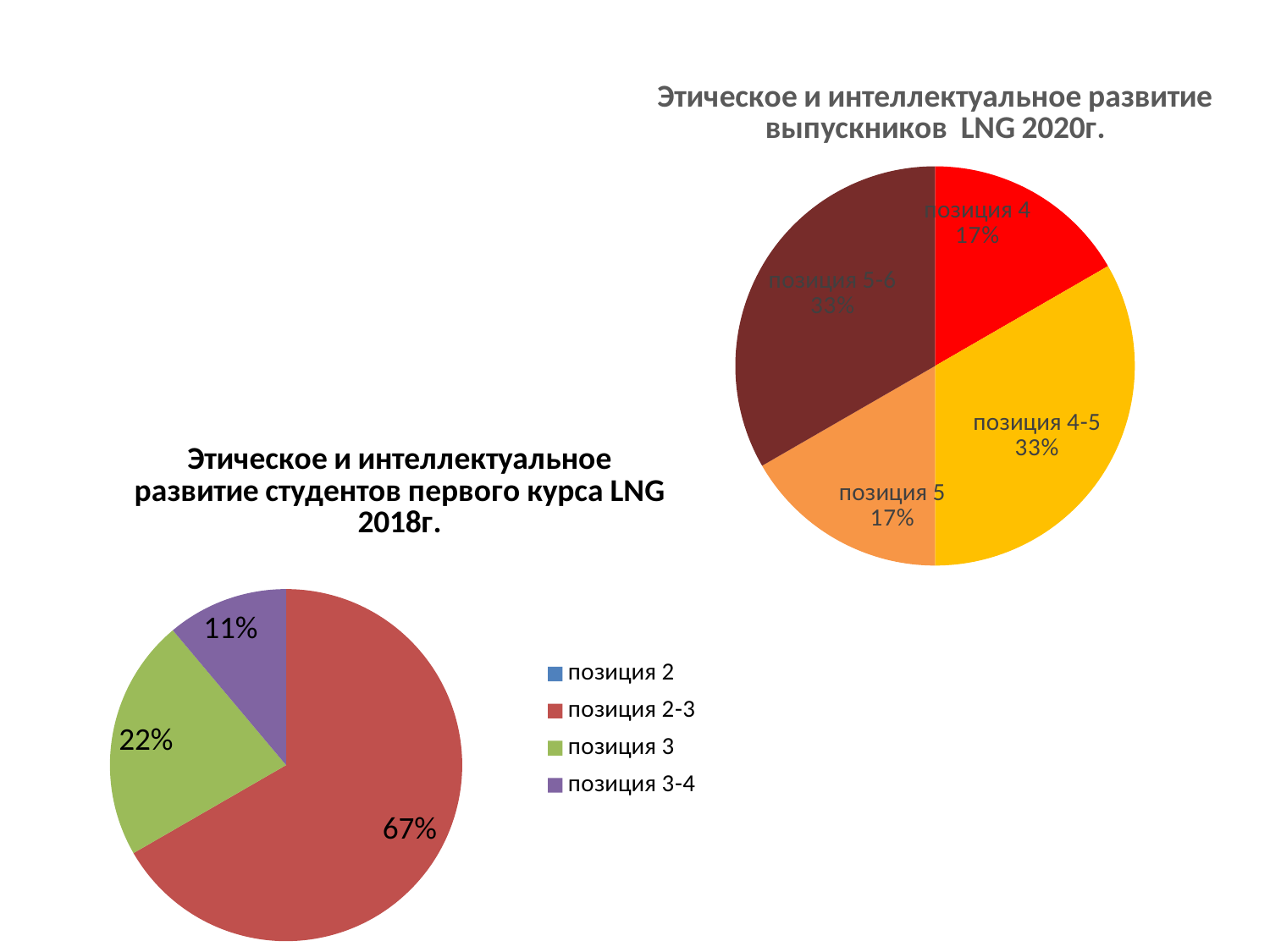
In the 2020 graduates chart, what share does позиция 4-5 have? 33% In the 2018 first-year students chart, what colour is the slice for позиция 3? Green In the 2018 first-year students chart, what is the difference between the shares of позиция 2-3 and позиция 3? 45% In the 2020 graduates chart, what share does позиция 5 have? 17% What type of chart is the 2020 graduates chart? Pie chart In the 2018 first-year students chart, what share does позиция 2-3 have? 67% In the 2018 first-year students chart, how many entries does the legend list? 4 In the 2018 first-year students chart, which category has the largest slice? позиция 2-3 In the 2018 first-year students chart, what share does позиция 3-4 have? 11% In the 2020 graduates chart, which is larger: позиция 4 or позиция 5-6? позиция 5-6 In the 2020 graduates chart, how many slices does the pie have? 4 In the 2018 first-year students chart, what share does позиция 3 have? 22%